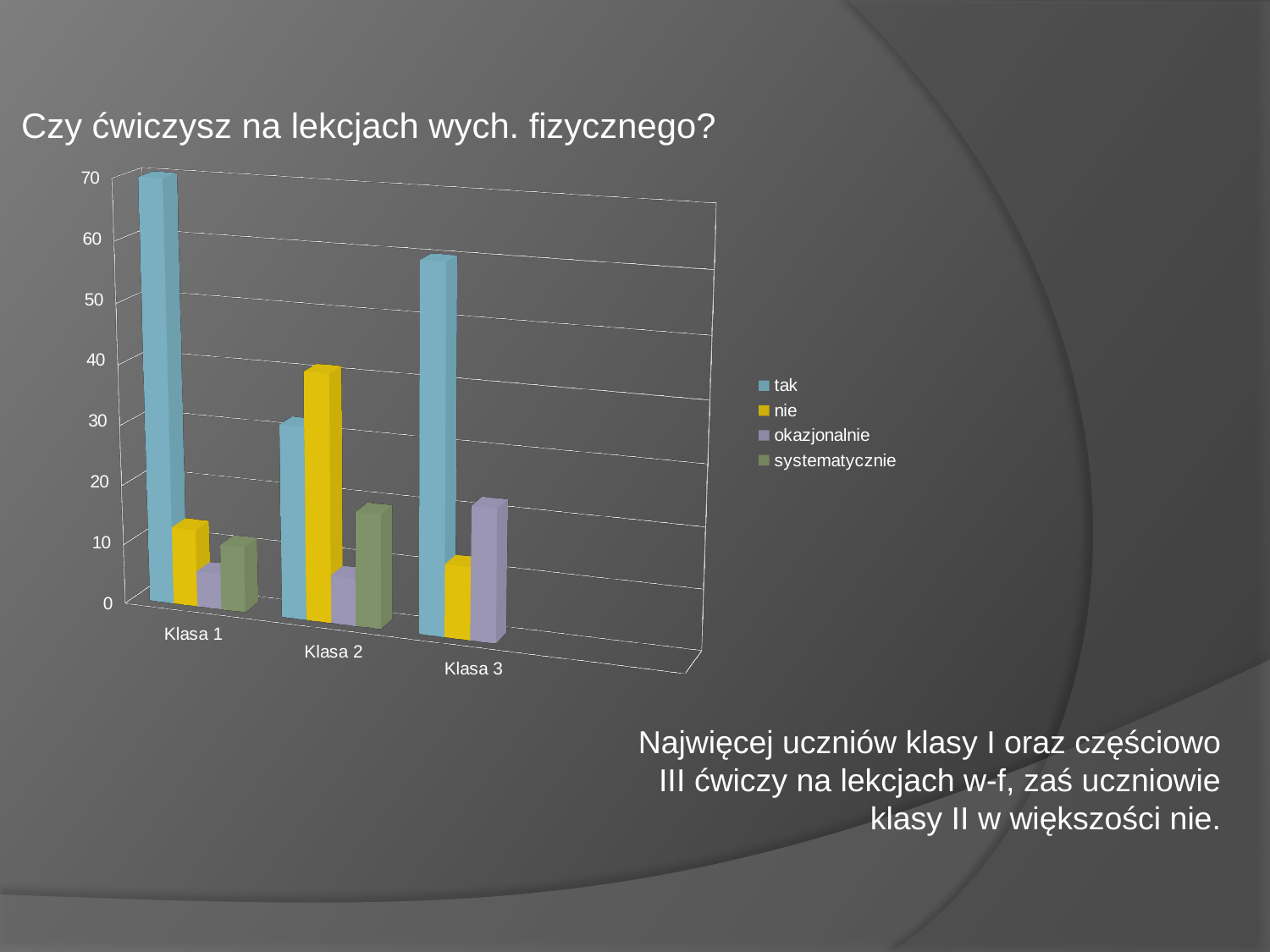
How many classes (categories) are shown on the x axis of the chart? 3 Which class has the highest value for the 'tak' series? Klasa 1 What question is the chart titled with? Czy ćwiczysz na lekcjach wych. fizycznego? Which class has the highest value for the 'nie' series? Klasa 2 Is the value for 'tak' in Klasa 3 greater or less than 50? greater Which class has the lowest value for the 'tak' series? Klasa 2 Which series is shown in yellow in the chart legend? nie In Klasa 1, which is larger: the 'tak' bar or the 'nie' bar? tak How many series does the chart legend list? 4 What kind of chart is shown on the slide? bar chart In Klasa 2, which is larger: the 'tak' bar or the 'nie' bar? nie Is the value for 'nie' in Klasa 1 greater or less than 20? less